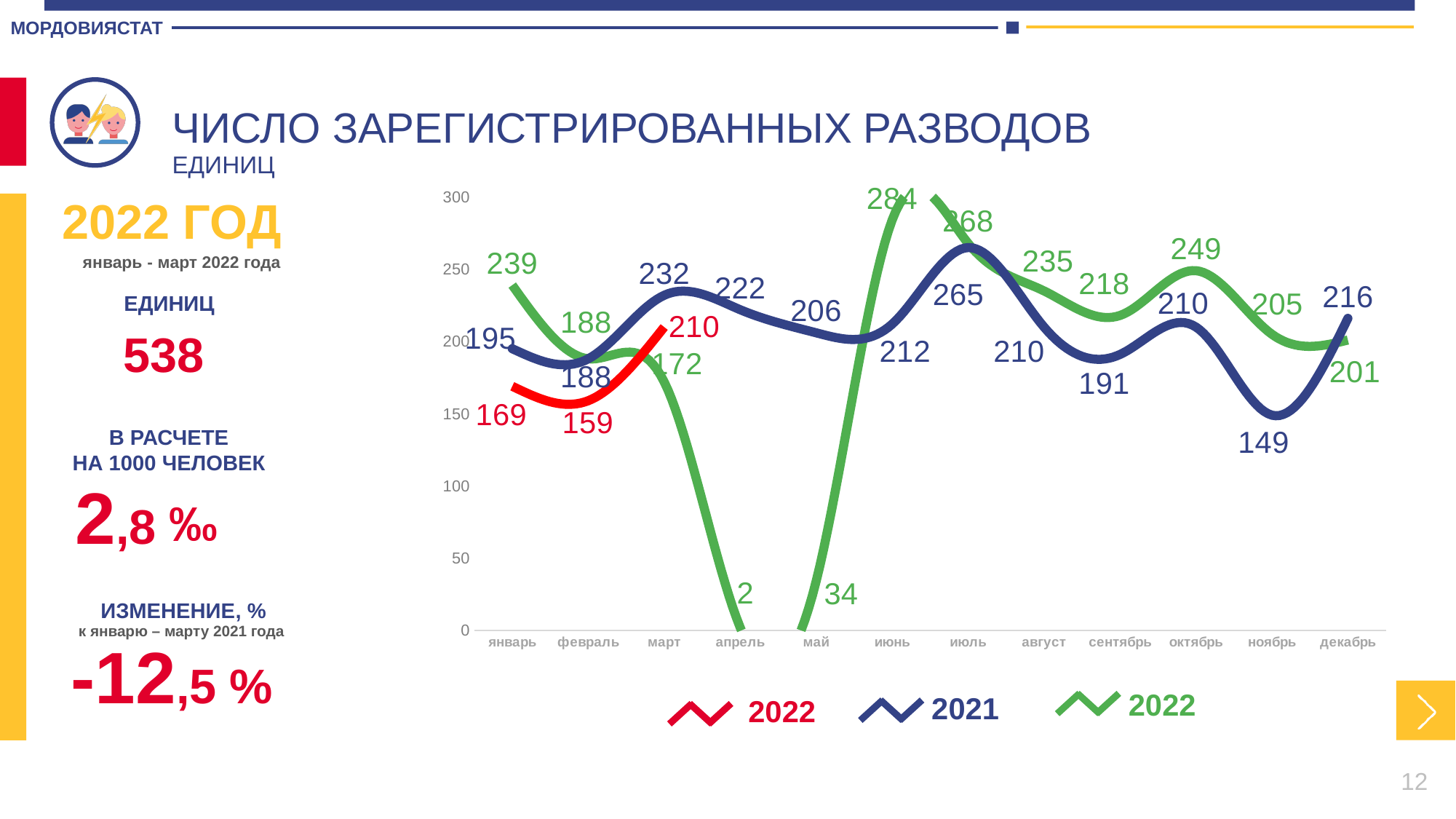
How many months are shown on the x axis? 12 What is the value of the blue 2021 line for июль? 265 What is the difference between the blue 2021 values for март and февраль? 44 Which is larger for январь: the blue 2021 value or the green line value? green line (239) What is the value of the red 2022 line for март? 210 In which month does the green line reach its highest value? июнь What is the value of the green line for апрель? 2 Does the red 2022 line rise or fall from февраль to март? rise What type of chart is shown on the slide? line chart In which month does the blue 2021 line reach its lowest value? ноябрь How many series does the legend list? 3 What is the difference between the green line values for май and апрель? 32